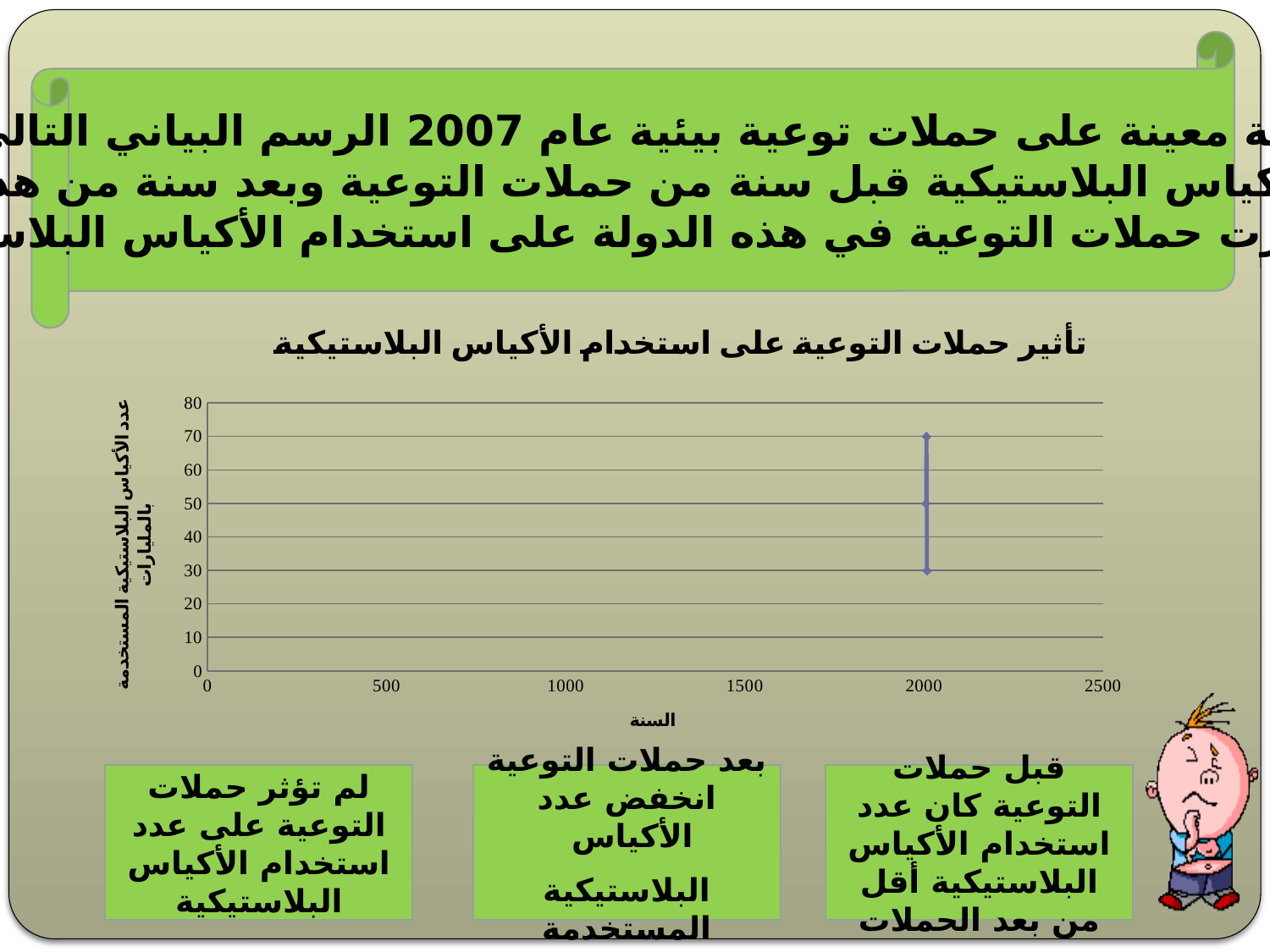
What is the highest value reached by a plotted point on the y axis? 70 How many data points are plotted on the chart? 3 What is the lowest value reached by a plotted point on the y axis? 30 What is the label of the x axis? السنة Are the plotted points located at an x value greater or less than 1500? greater What is the maximum value shown on the x axis? 2500 What is the difference between the highest and lowest plotted y values? 40 Is the highest plotted point greater or less than 60 on the y axis? greater What is the title of the chart? تأثير حملات التوعية على استخدام الأكياس البلاستيكية Is the lowest plotted point greater or less than 40 on the y axis? less What kind of chart is shown on the slide? line chart